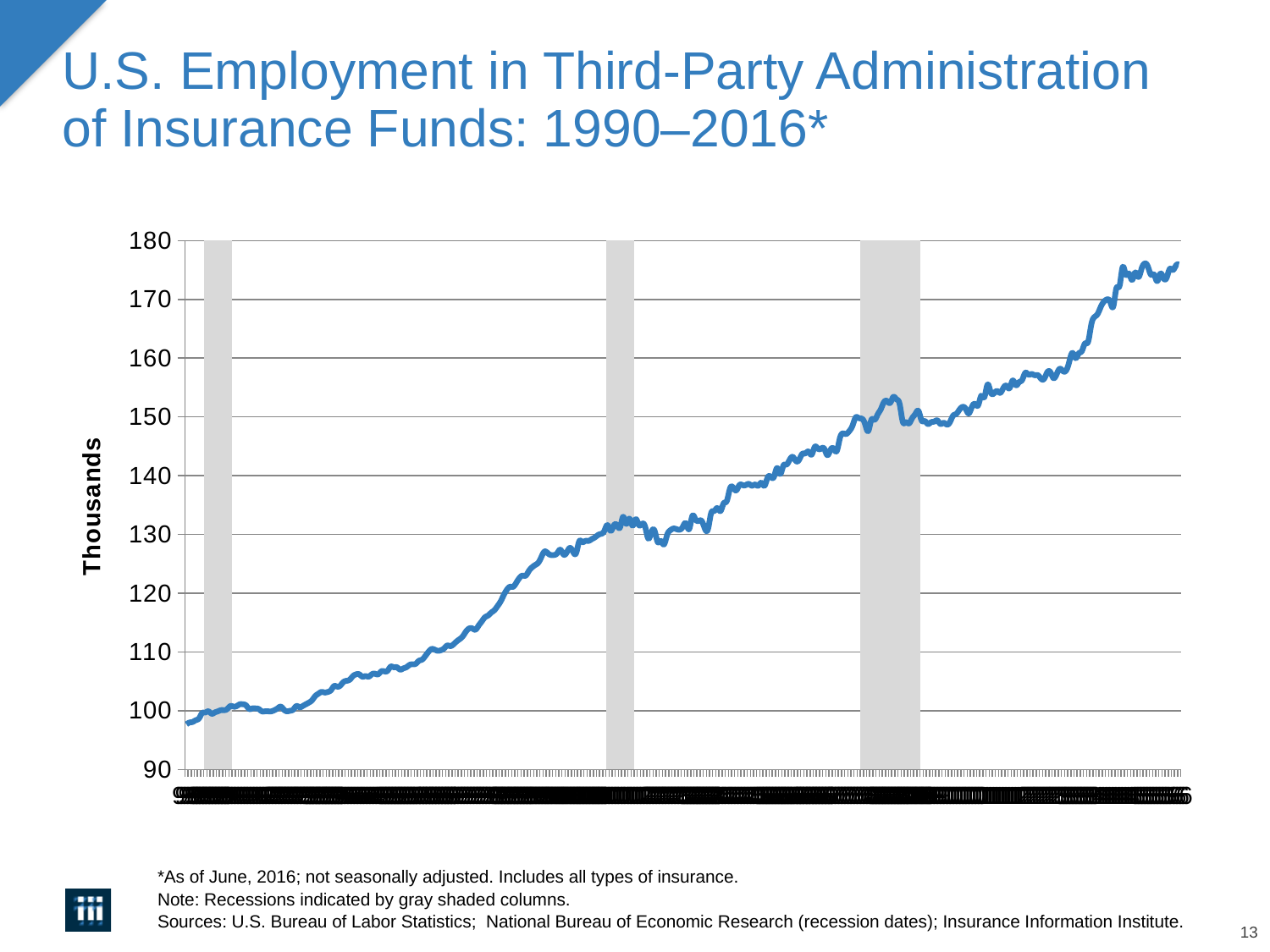
Is the value at the right end of the line (2016) greater or less than 170? greater What is the label on the vertical axis? Thousands Is the value at the right end of the line greater or less than 180? less Do the values generally rise or fall from left to right along the x axis? rise Which end of the line is higher, the left end (1990) or the right end (2016)? the right end (2016) What is the highest value shown on the vertical axis? 180 Is the highest value on the line greater or less than 170? greater What kind of chart is shown on the slide? line chart What is the title of the chart? U.S. Employment in Third-Party Administration of Insurance Funds: 1990–2016*